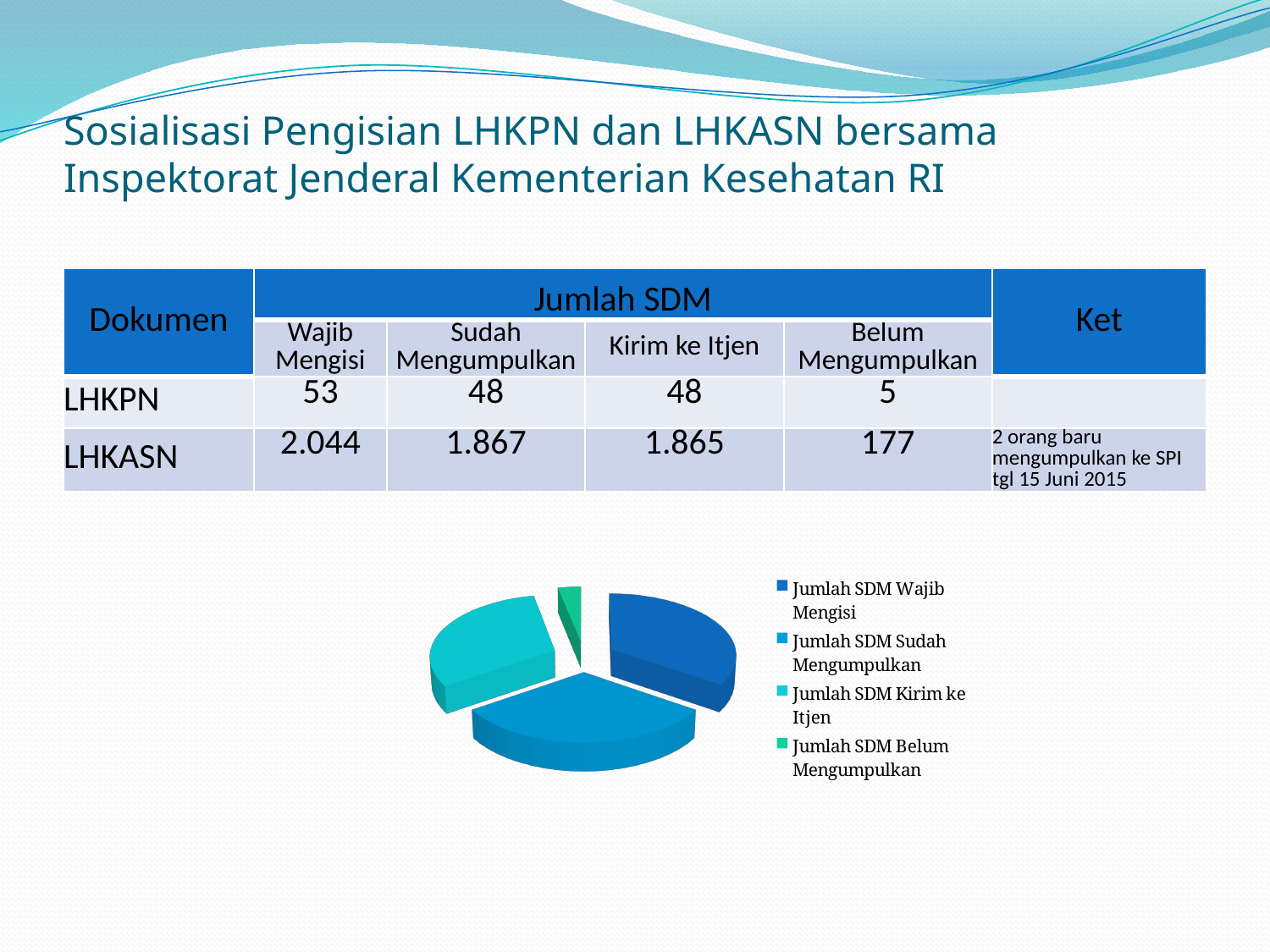
What is the last entry listed in the pie chart's legend? Jumlah SDM Belum Mengumpulkan Which slice is larger in the pie chart: Jumlah SDM Kirim ke Itjen or Jumlah SDM Belum Mengumpulkan? Jumlah SDM Kirim ke Itjen How many entries does the pie chart's legend list? 4 Which legend entry corresponds to the smallest slice of the pie chart? Jumlah SDM Belum Mengumpulkan What is the first entry listed in the pie chart's legend? Jumlah SDM Wajib Mengisi Which slice is larger in the pie chart: Jumlah SDM Wajib Mengisi or Jumlah SDM Belum Mengumpulkan? Jumlah SDM Wajib Mengisi What kind of chart is shown on the slide? pie chart How many slices does the pie chart have? 4